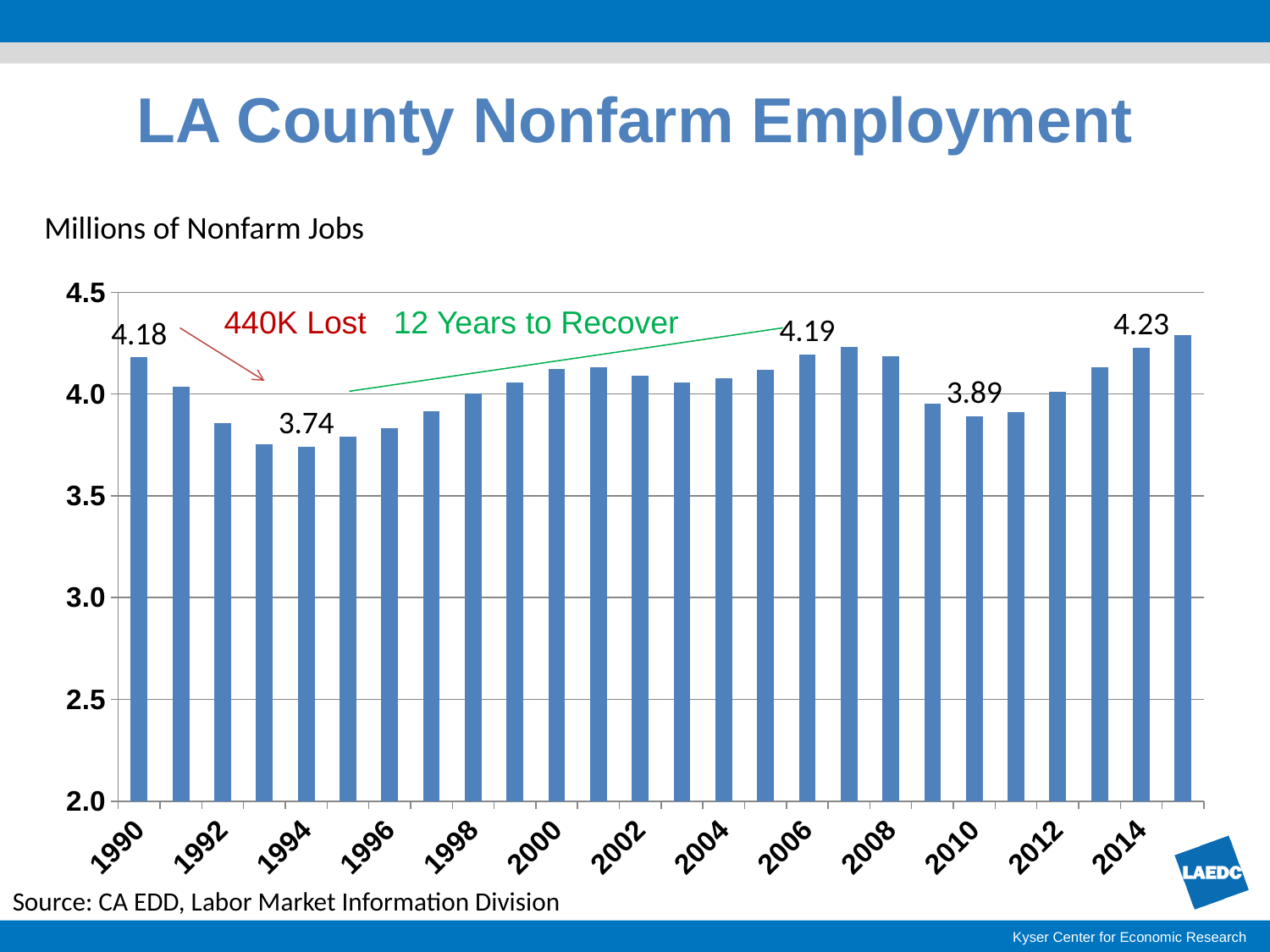
Do the values rise or fall from 1990 to 1994? fall What kind of chart is shown on the slide? bar chart How many bars are plotted in the chart? 26 Is the value for 1992 greater or less than 4.0? less What is the difference between the values for 1990 and 1994? 0.44 What is the value for 2014? 4.23 What is the value for 1994? 3.74 Which year has the larger value, 1990 or 2006? 2006 Is the value for 2000 greater or less than 4.0? greater What is the value for 2010? 3.89 What is the value for 2006? 4.19 What is the value for 1990? 4.18